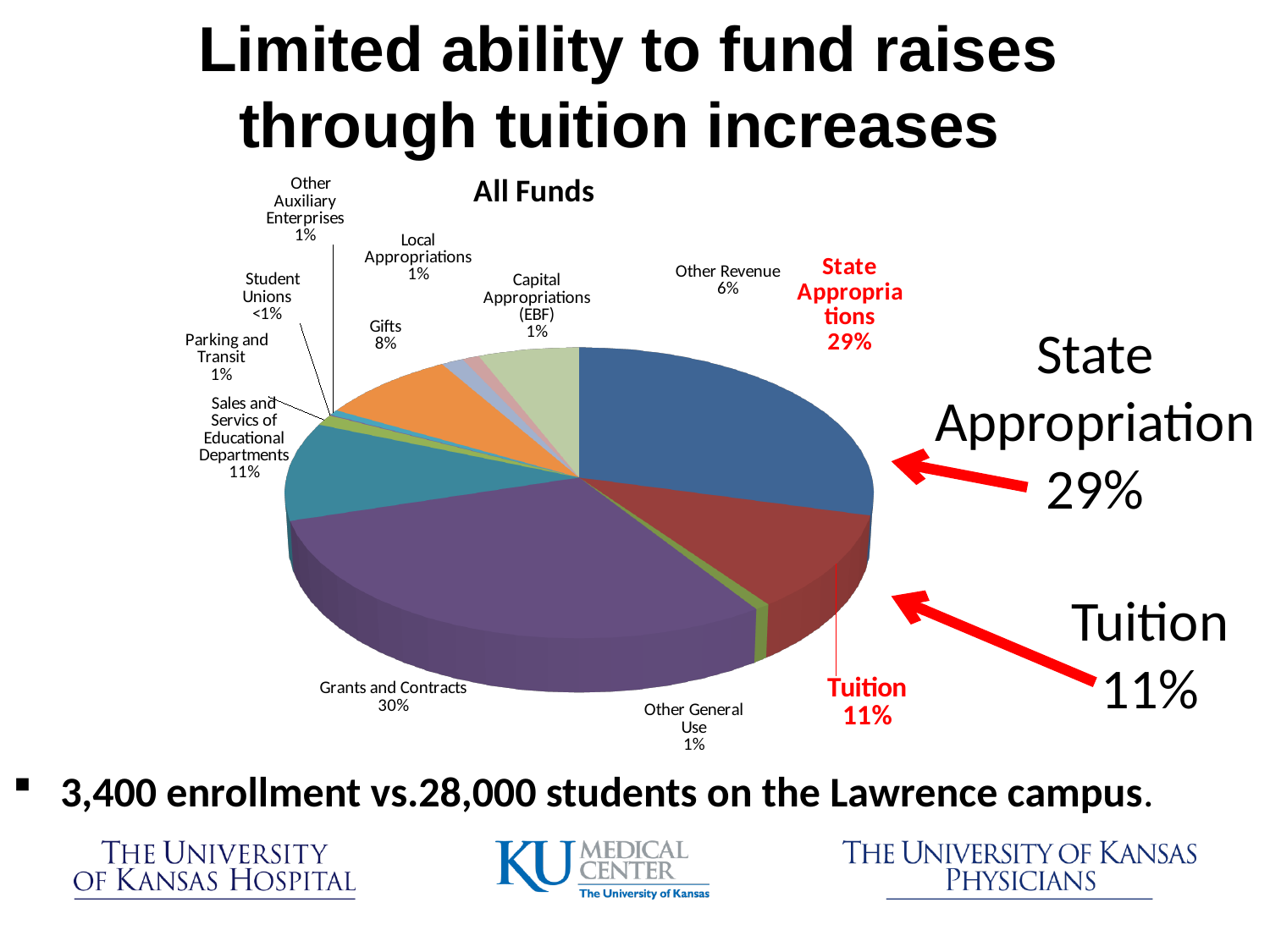
What share of All Funds comes from Other Revenue? 6% What type of chart is shown on the slide? pie chart What is the difference in percentage points between State Appropriations and Tuition? 18 What share of All Funds comes from Gifts? 8% What share of All Funds comes from Tuition? 11% How many categories are shown in the All Funds pie chart? 12 What share of All Funds comes from State Appropriations? 29% Which category has the largest share of All Funds? Grants and Contracts Which is larger, the share for Gifts or the share for Other Revenue? Gifts Which category has the smallest share of All Funds? Student Unions What share of All Funds comes from Grants and Contracts? 30% What is the title of the chart? All Funds